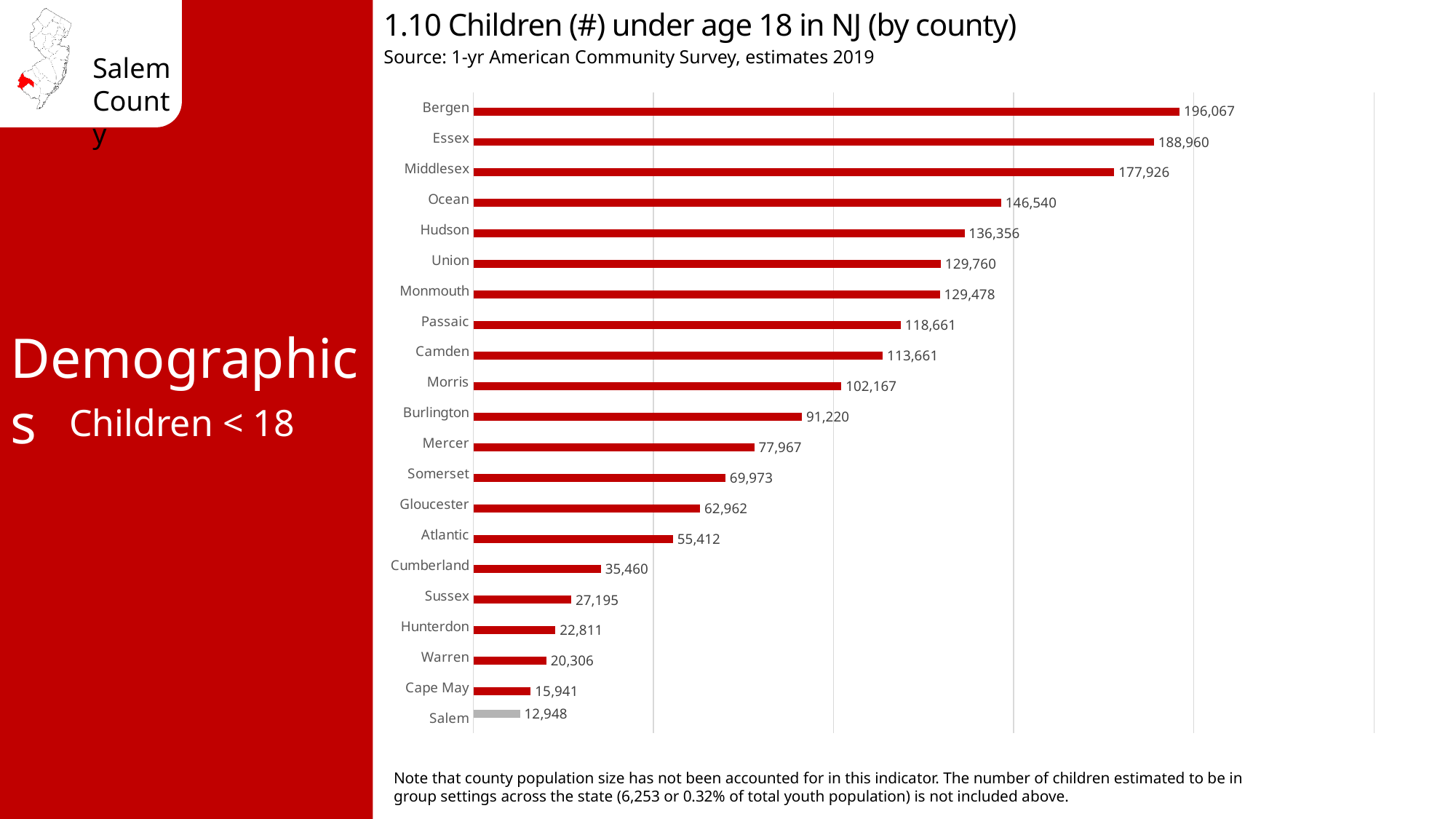
Which county has the lowest number of children under age 18? Salem What is the value shown for Salem county? 12,948 How many children under 18 are shown for Gloucester county? 62,962 How many counties are shown in the chart? 21 Which county has a larger value, Burlington or Mercer? Burlington Which county's bar is coloured grey instead of red? Salem What is the difference between the values for Bergen and Salem? 183,119 What kind of chart is shown on the slide? Bar chart What is the difference between the values for Ocean and Hudson? 10,184 Which county has the highest number of children under age 18? Bergen What is the source of the data cited under the chart title? 1-yr American Community Survey, estimates 2019 What is the number of children under age 18 in Bergen county? 196,067